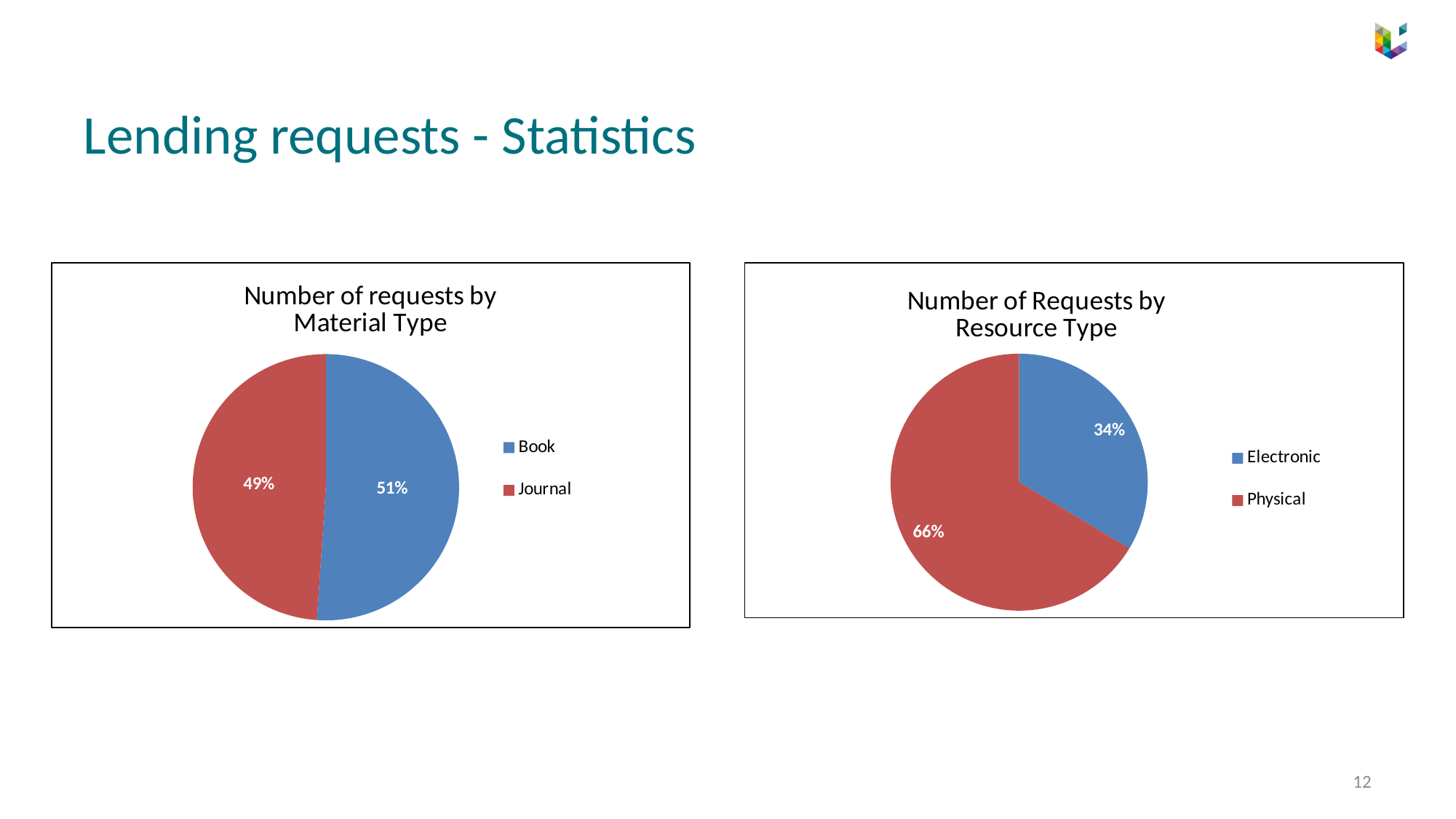
In the 'Number of Requests by Resource Type' chart, which resource type has the smallest share? Electronic In the 'Number of Requests by Resource Type' chart, what share of requests are Electronic? 34% In the 'Number of Requests by Resource Type' chart, what share of requests are Physical? 66% In the 'Number of Requests by Resource Type' chart, what is the difference in percentage points between Physical and Electronic? 32 percentage points How many categories does the 'Number of Requests by Resource Type' chart show? 2 In the 'Number of requests by Material Type' chart, what is the difference in percentage points between Book and Journal? 2 percentage points In the 'Number of requests by Material Type' chart, which colour represents Journal? Red What type of chart is the 'Number of requests by Material Type' chart? Pie chart In the 'Number of requests by Material Type' chart, what share of requests are for Books? 51% What is the title of the chart on the right side of the slide? Number of Requests by Resource Type In the 'Number of Requests by Resource Type' chart, which resource type has the largest share? Physical